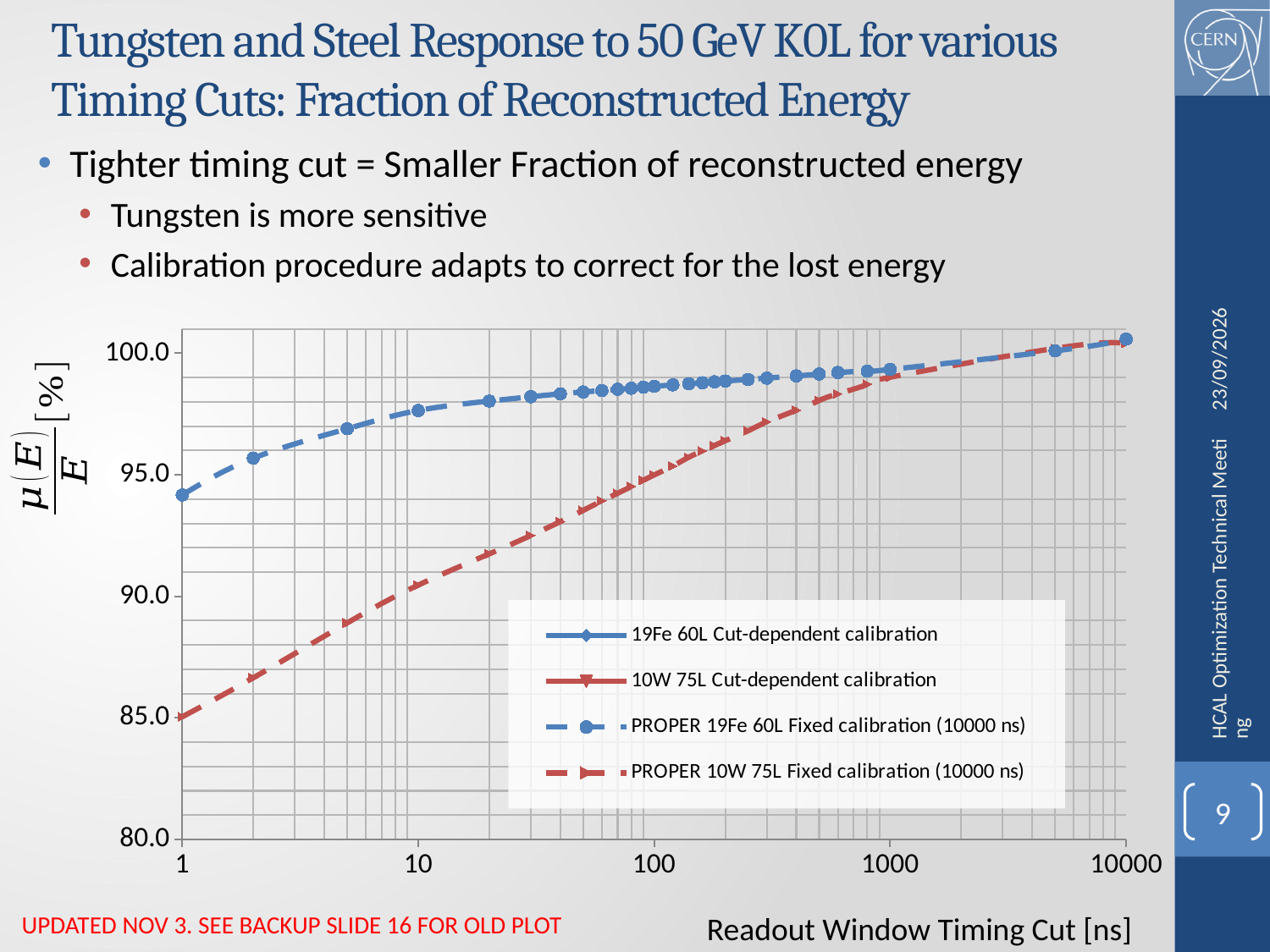
What is the largest tick value shown on the x axis of the chart? 10000 At a timing cut of 100 ns, which series has the lower value: PROPER 19Fe 60L Fixed calibration or PROPER 10W 75L Fixed calibration? PROPER 10W 75L Fixed calibration Does the PROPER 19Fe 60L Fixed calibration series rise or fall as the timing cut increases along the x axis? rise How many series does the chart legend list? 4 Is the value of the PROPER 10W 75L Fixed calibration series at a timing cut of 1000 ns greater or less than 95.0? greater Is the value of the PROPER 19Fe 60L Fixed calibration series at a timing cut of 1 ns greater or less than 90.0? greater Does the PROPER 10W 75L Fixed calibration series rise or fall as the timing cut increases along the x axis? rise What kind of chart is shown on the slide? line chart Is the value of the PROPER 10W 75L Fixed calibration series at a timing cut of 1 ns greater or less than 90.0? less At a timing cut of 1 ns, which series has the higher value: PROPER 19Fe 60L Fixed calibration or PROPER 10W 75L Fixed calibration? PROPER 19Fe 60L Fixed calibration What is the label of the x axis of the chart? Readout Window Timing Cut [ns]